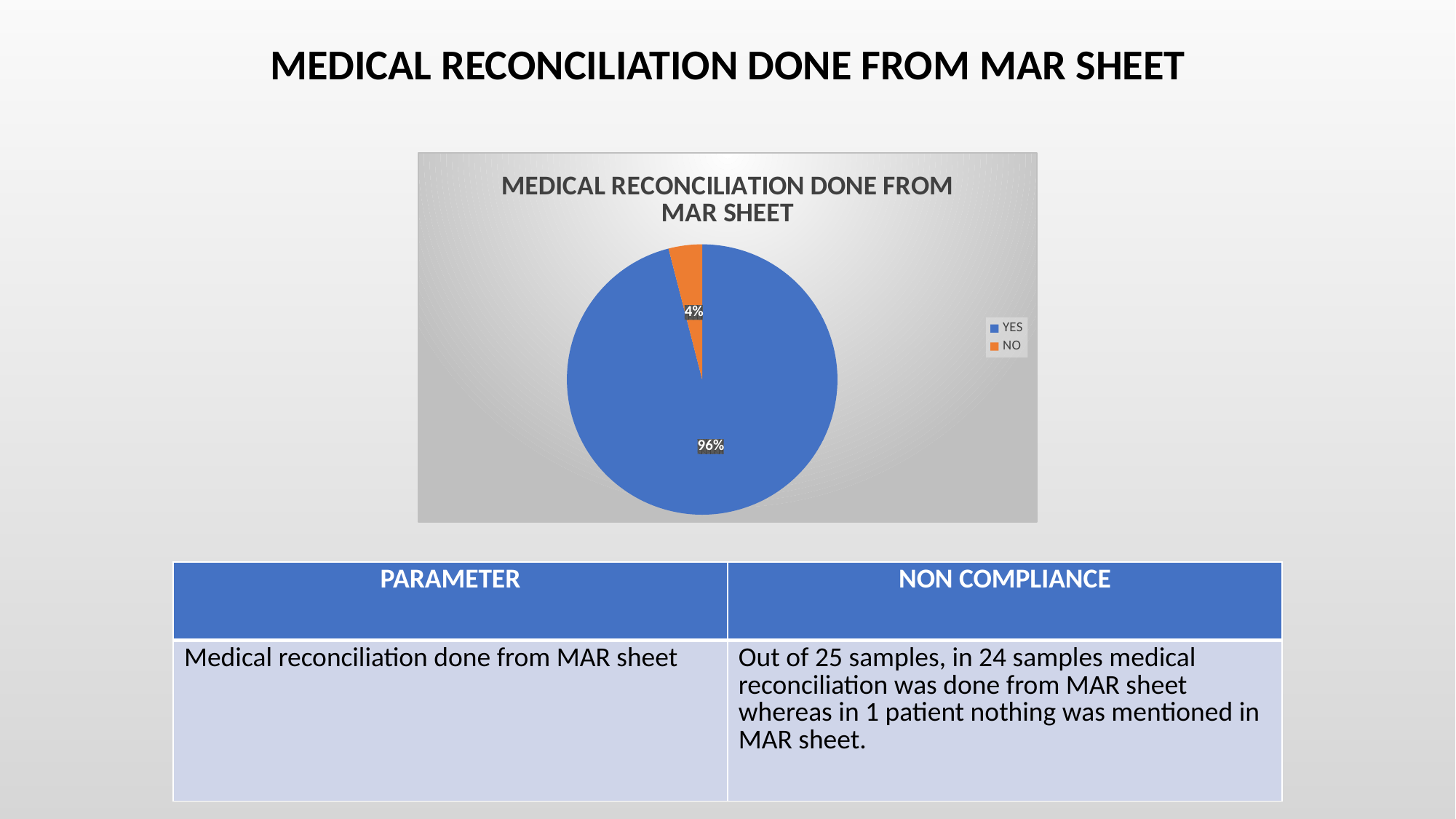
Which category has the largest slice of the pie? YES What is the difference in percentage points between the YES and NO slices? 92 What is the total of the two slice percentages shown on the pie chart? 100% Which slice is larger, YES or NO? YES Which category has the smallest slice of the pie? NO What share of the pie does the YES slice represent? 96% What share of the pie does the NO slice represent? 4% What colour is the NO slice in the pie chart? Orange What is the title of the chart? MEDICAL RECONCILIATION DONE FROM MAR SHEET What kind of chart is shown on the slide? Pie chart How many categories are shown in the pie chart? 2